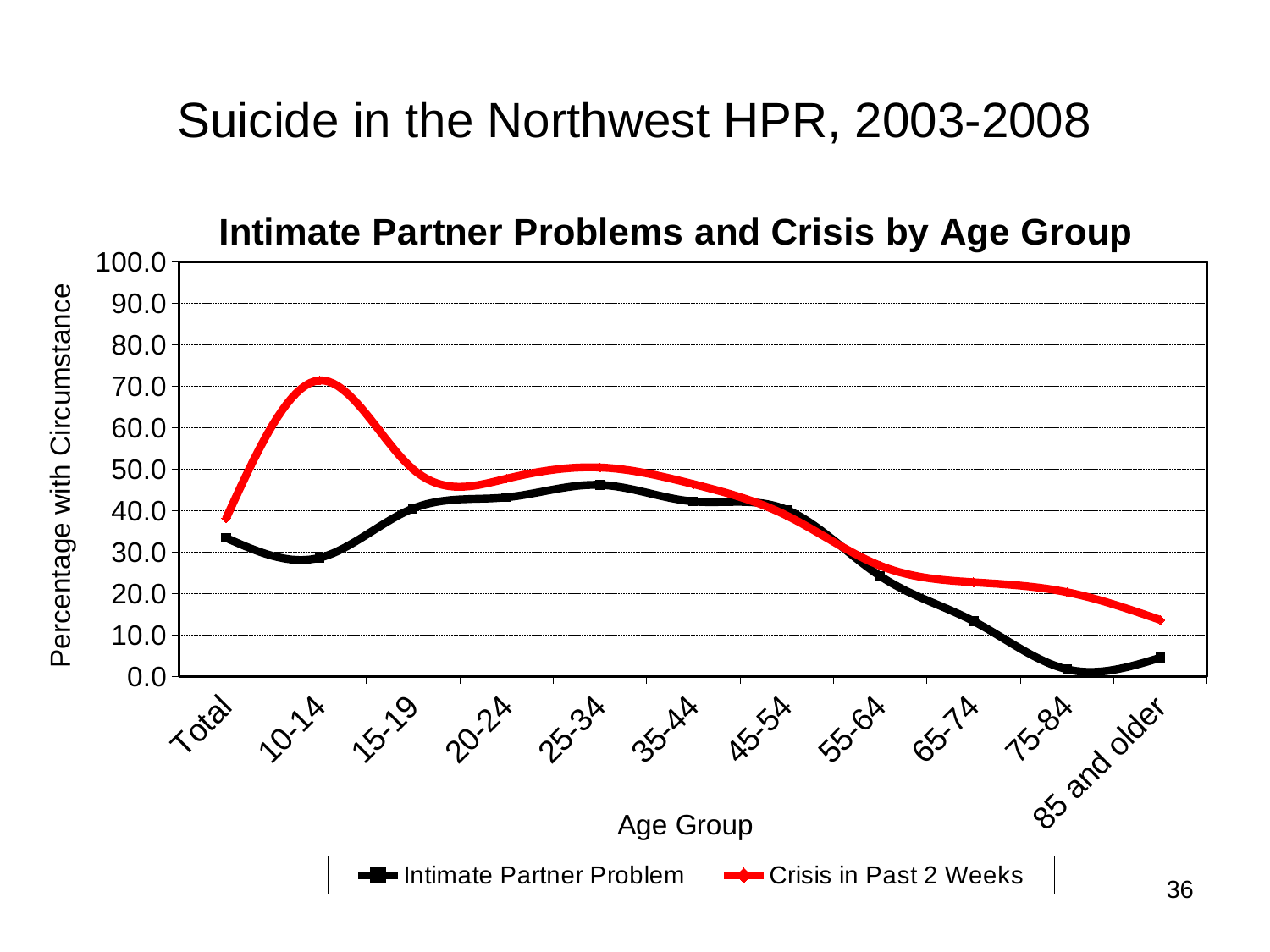
How many age group categories are shown on the x axis? 11 How many series does the legend list? 2 Is the Crisis in Past 2 Weeks value for the 10-14 age group greater or less than 60.0? greater For which age group is the Intimate Partner Problem value highest? 25-34 For the 10-14 age group, which series has the larger value, Intimate Partner Problem or Crisis in Past 2 Weeks? Crisis in Past 2 Weeks What kind of chart is shown on the slide? line chart For which age group is the Intimate Partner Problem value lowest? 75-84 For which age group is the Crisis in Past 2 Weeks value lowest? 85 and older Does the Intimate Partner Problem line rise or fall from the 45-54 age group to the 75-84 age group? fall For which age group is the Crisis in Past 2 Weeks value highest? 10-14 Is the Intimate Partner Problem value for the 75-84 age group greater or less than 10.0? less What is the title of the chart? Intimate Partner Problems and Crisis by Age Group